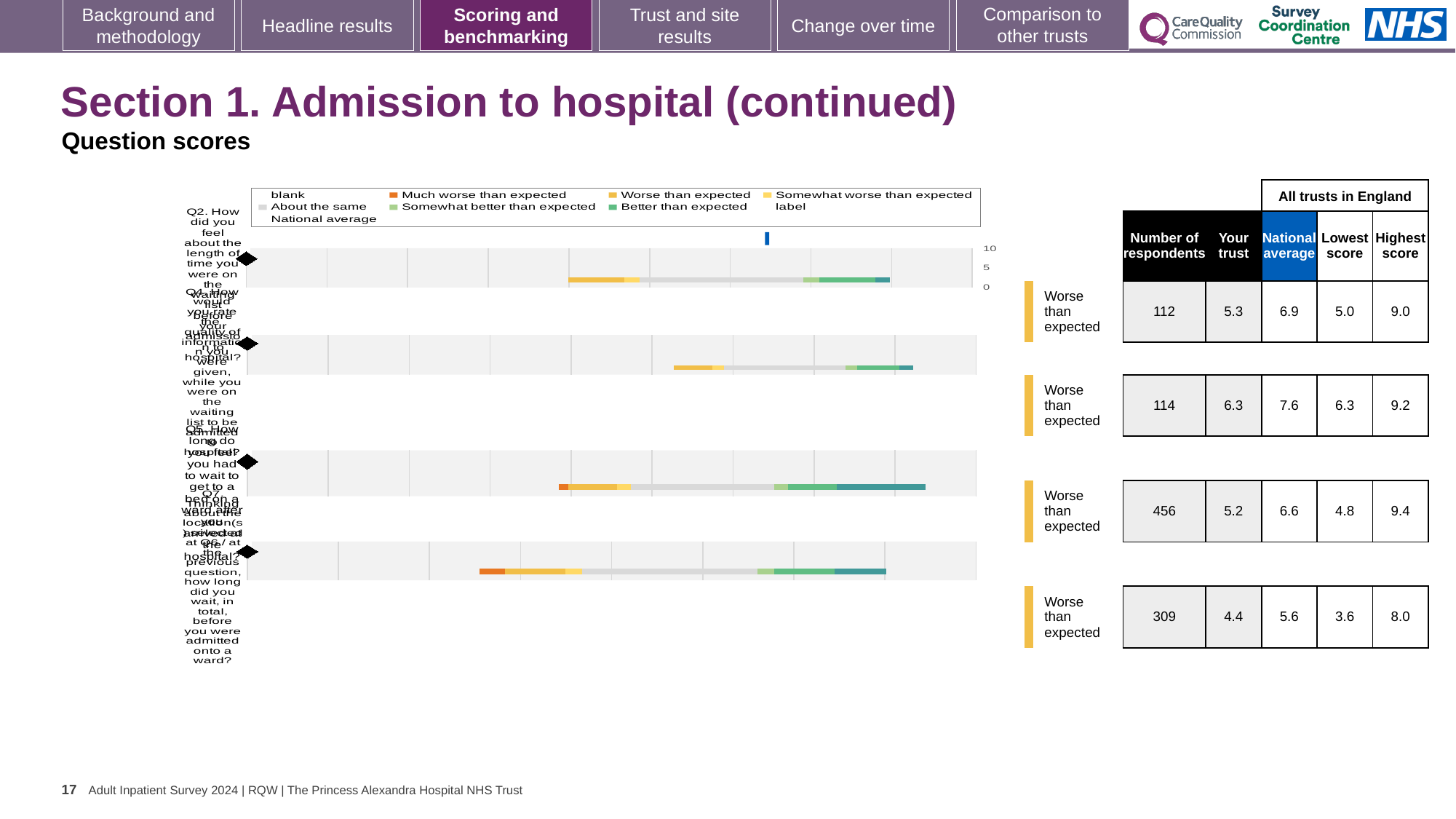
How many horizontal bars (question rows) are plotted in the chart? 4 In the table beside the chart, is the 'Your trust' score in the second row larger or smaller than the national average in that row? smaller What benchmark label is shown next to each of the four bars? Worse than expected In the table beside the chart, which row has the lowest 'Your trust' score? the fourth row (4.4) In the chart legend, which colour represents 'Better than expected'? teal In the table beside the chart, what is the 'Your trust' score for the first row? 5.3 In the chart legend, which colour represents 'Much worse than expected'? orange In the table beside the chart, what is the number of respondents for the third row? 456 What kind of chart is shown on the slide? bar chart In the table beside the chart, which row has the highest 'National average'? the second row (7.6) In the table beside the chart, what is the difference between the national average and the trust score in the fourth row? 1.2